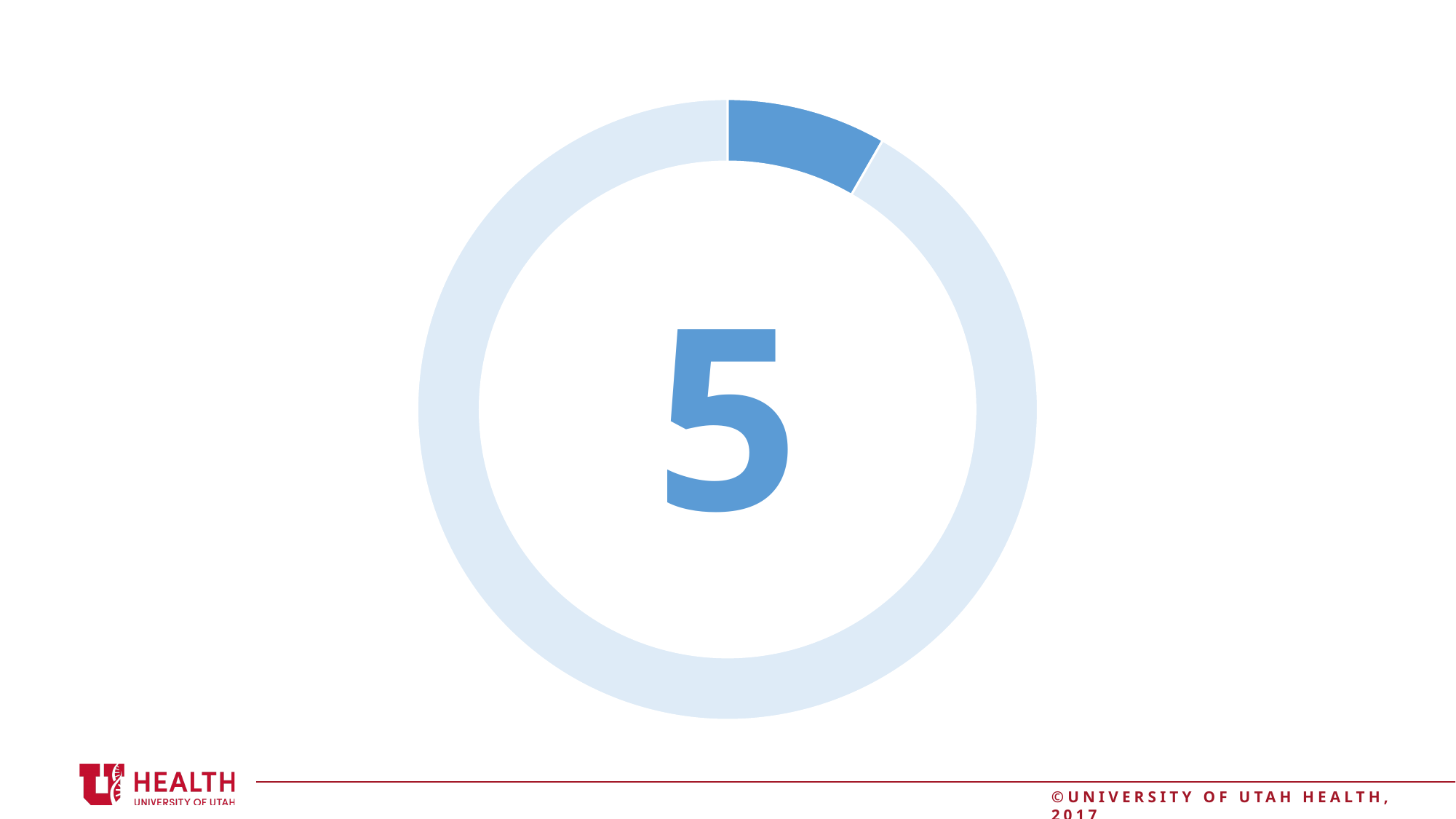
Which slice of the doughnut chart is larger, the dark blue slice or the light blue slice? the light blue slice Which slice of the doughnut chart is the smallest? the dark blue slice What kind of chart is shown on the slide? doughnut chart What number is printed in the centre of the doughnut chart? 5 Does the doughnut chart have a legend? No How many slices does the doughnut chart have? 2